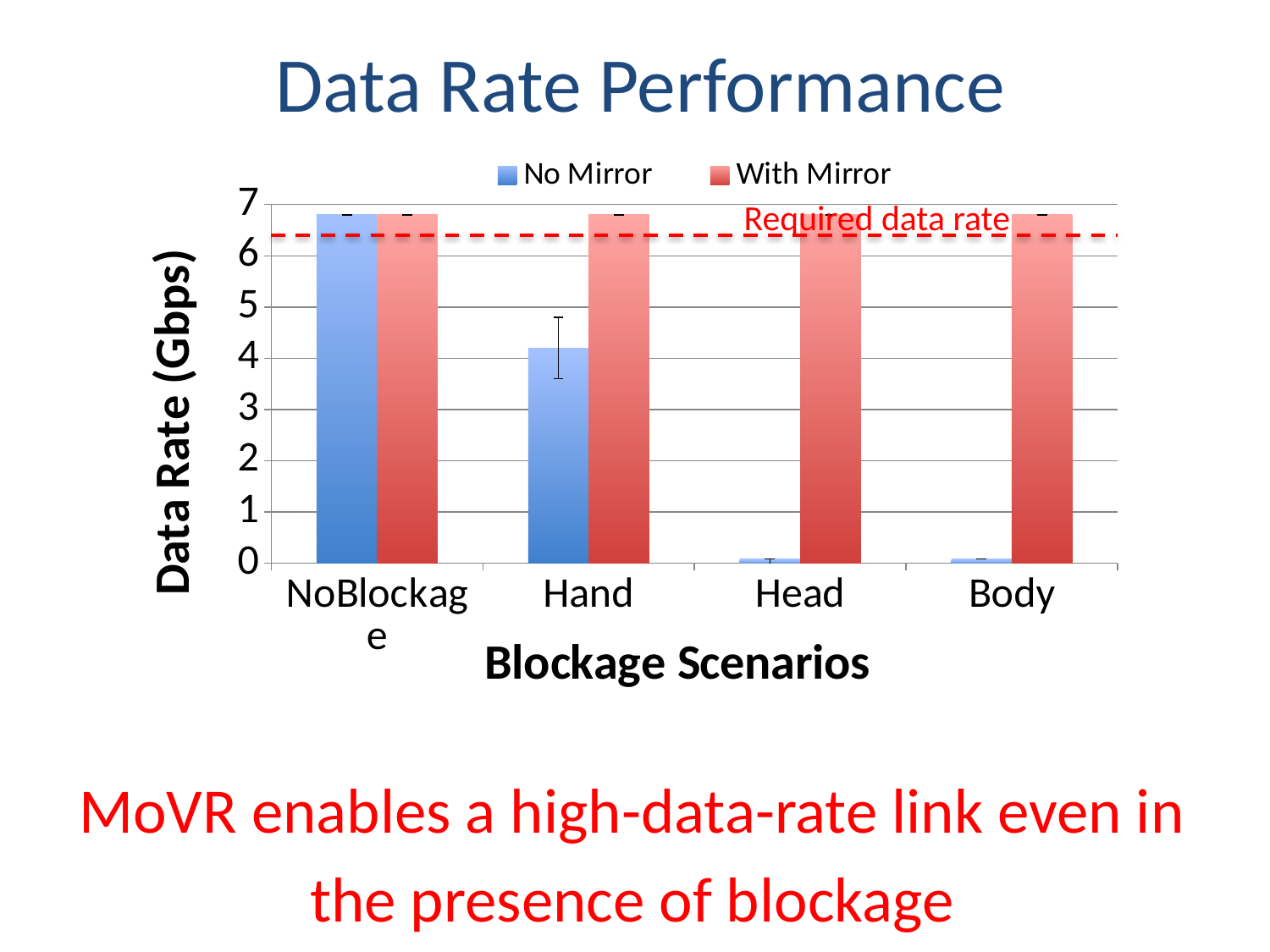
Is the No Mirror value for Body greater or less than 1? less What is the title of the y axis? Data Rate (Gbps) How many series does the legend list? 2 Is the No Mirror value for Hand greater or less than 5? less Do the No Mirror values rise or fall moving from NoBlockage to Body along the x axis? Fall How many blockage scenarios are shown on the x axis? 4 For the Hand scenario, which is larger: the No Mirror value or the With Mirror value? With Mirror What kind of chart is shown on the slide? Bar chart What does the red dashed horizontal line represent? Required data rate Which blockage scenario has the highest No Mirror data rate? NoBlockage Is the With Mirror value for Head greater or less than 6? greater